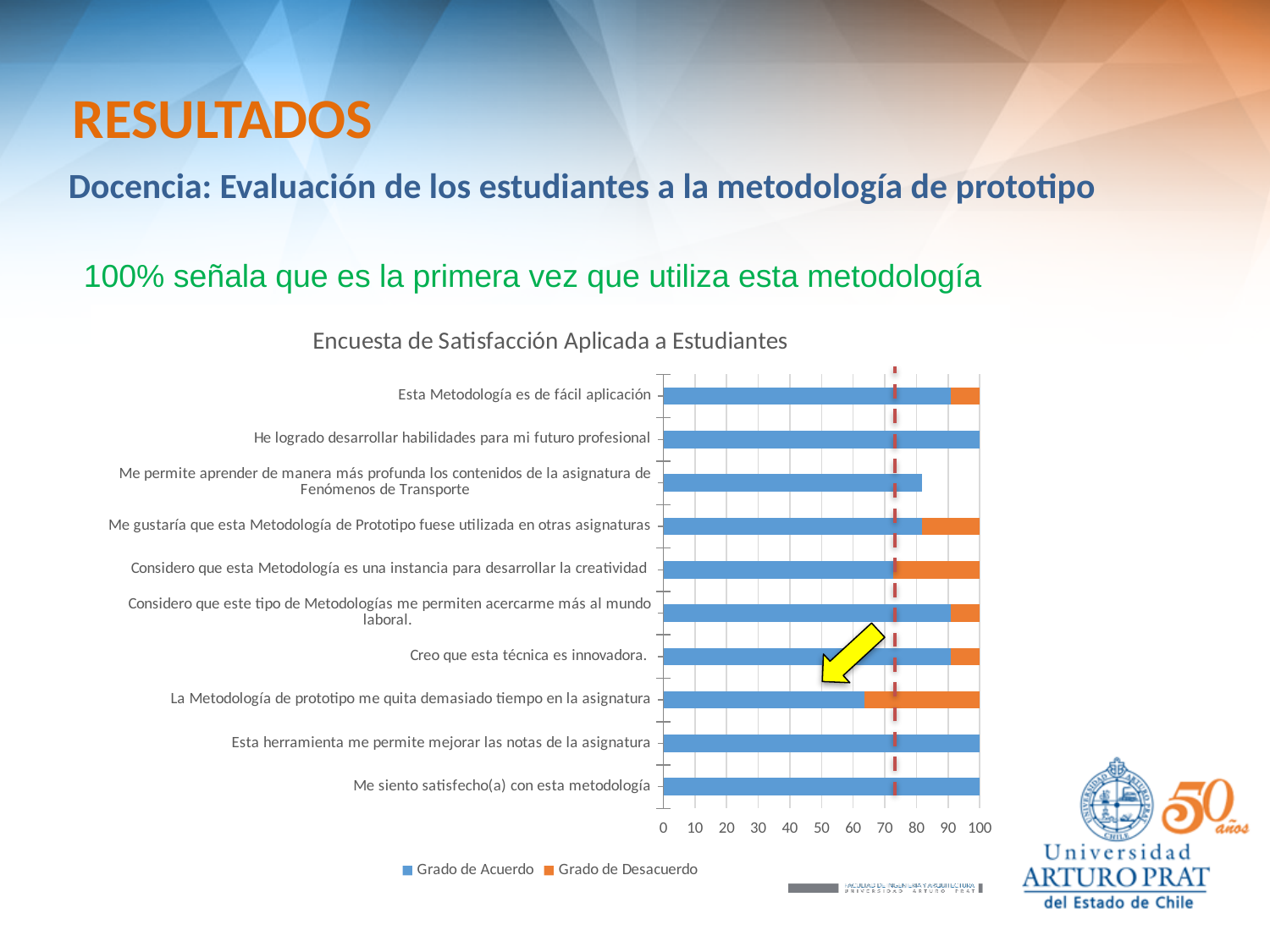
Which series is shown in blue in the chart? Grado de Acuerdo What is the Grado de Acuerdo value for 'He logrado desarrollar habilidades para mi futuro profesional'? 100 Is the Grado de Acuerdo value for 'Esta Metodología es de fácil aplicación' greater or less than 80? greater Which statement has the lowest Grado de Acuerdo value? La Metodología de prototipo me quita demasiado tiempo en la asignatura Which has the larger Grado de Acuerdo value: 'Creo que esta técnica es innovadora.' or 'Considero que esta Metodología es una instancia para desarrollar la creatividad'? Creo que esta técnica es innovadora. How many categories (statements) are plotted in the chart? 10 How many series does the chart legend list? 2 What type of chart is shown on the slide? bar chart Is the Grado de Acuerdo value for 'La Metodología de prototipo me quita demasiado tiempo en la asignatura' greater or less than 70? less Which statement has the highest Grado de Desacuerdo value? La Metodología de prototipo me quita demasiado tiempo en la asignatura What is the Grado de Acuerdo value for 'Me siento satisfecho(a) con esta metodología'? 100 What is the title of the chart? Encuesta de Satisfacción Aplicada a Estudiantes